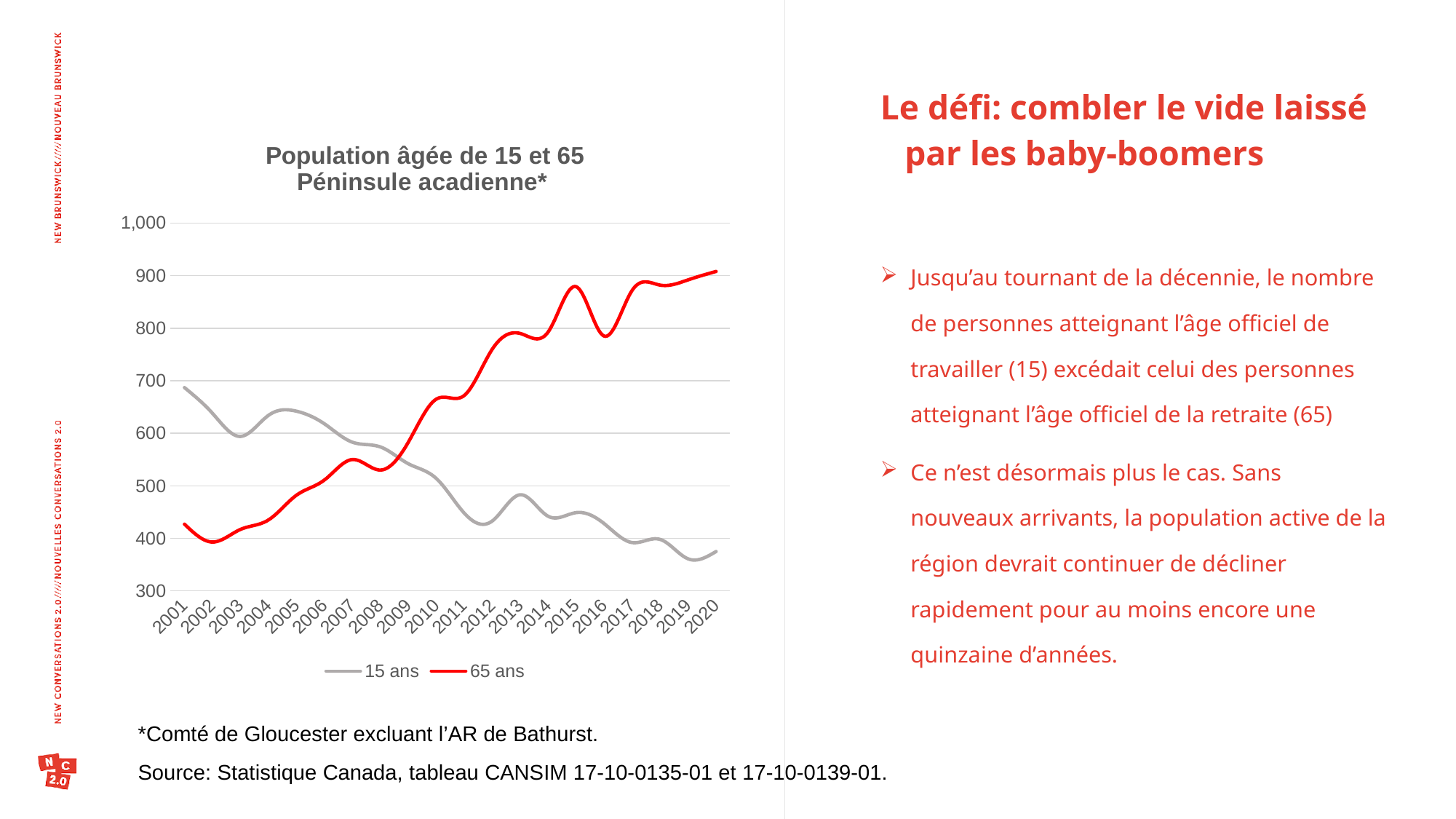
Is the value for '15 ans' in 2001 greater or less than 600? greater Does the '65 ans' series generally rise or fall from 2001 to 2020? rise What kind of chart is shown on the slide? line chart In which year does the '15 ans' series reach its highest value? 2001 In 2020, which series has the higher value, '15 ans' or '65 ans'? 65 ans Is the value for '15 ans' in 2019 greater or less than 400? less Does the '15 ans' series generally rise or fall from 2001 to 2020? fall Is the value for '65 ans' in 2002 greater or less than 500? less How many series does the legend of the chart list? 2 In 2001, which series has the higher value, '15 ans' or '65 ans'? 15 ans How many years are shown along the x axis of the chart? 20